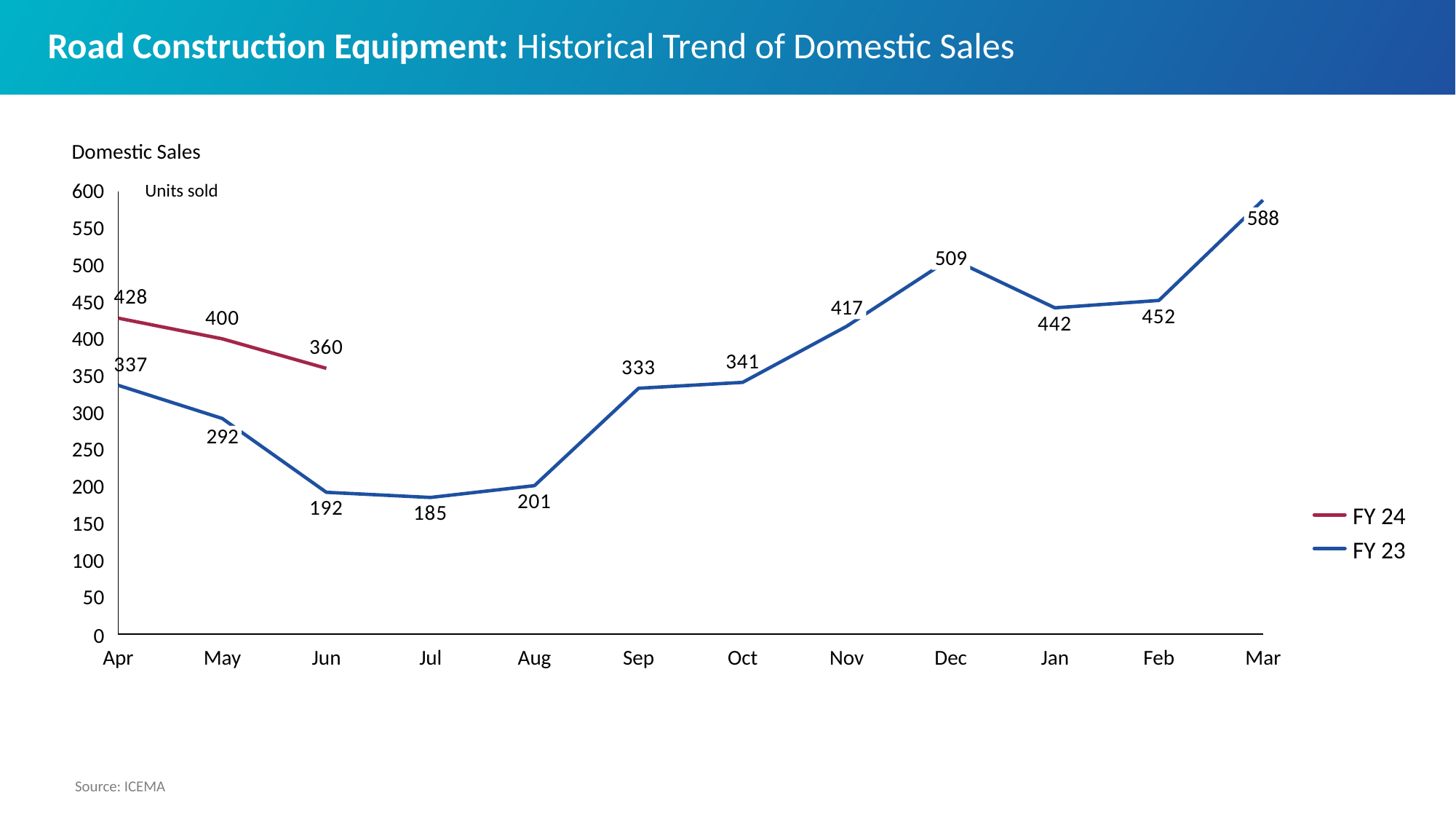
What is the difference between the FY 24 and FY 23 values for Apr? 91 What kind of chart is shown? Line chart How many months are shown on the x axis? 12 Is the FY 23 value for Nov greater or less than 400? greater Which month has the lowest FY 23 value? Jul How many series does the legend list? 2 What is the FY 24 value for Jun? 360 Which month has the highest FY 23 value? Mar What is the FY 23 value for Jul? 185 Do the FY 24 values rise or fall from Apr to Jun? Fall What is the FY 23 value for Dec? 509 Which is larger, the FY 23 value for Sep or the FY 23 value for Oct? Oct